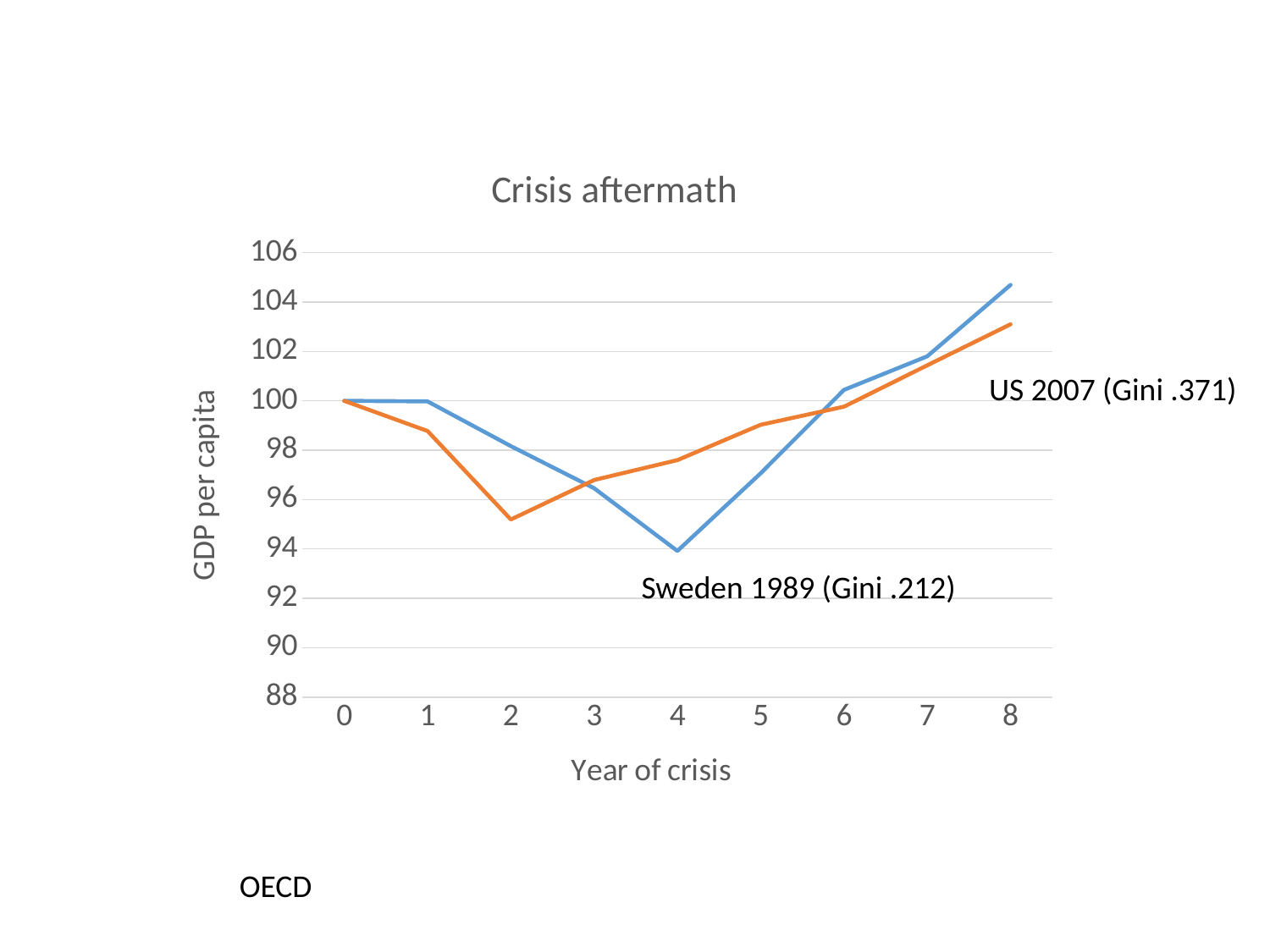
What is the title of the chart? Crisis aftermath What type of chart is shown on the slide? line chart At year 4 of the crisis, which series has the higher GDP per capita, Sweden 1989 or US 2007? US 2007 How many series are plotted in the chart? 2 Is the value for Sweden 1989 at year 4 greater or less than 96? less Is the value for US 2007 at year 8 greater or less than 102? greater What is the GDP per capita value for both series at year 0 of the crisis? 100 At which year of crisis does the Sweden 1989 line reach its lowest point? 4 At year 8 of the crisis, which series has the higher GDP per capita, Sweden 1989 or US 2007? Sweden 1989 At which year of crisis does the US 2007 line reach its lowest point? 2 Is the value for US 2007 at year 5 greater or less than 100? less How many points along the x axis (years of crisis) does each line cover? 9